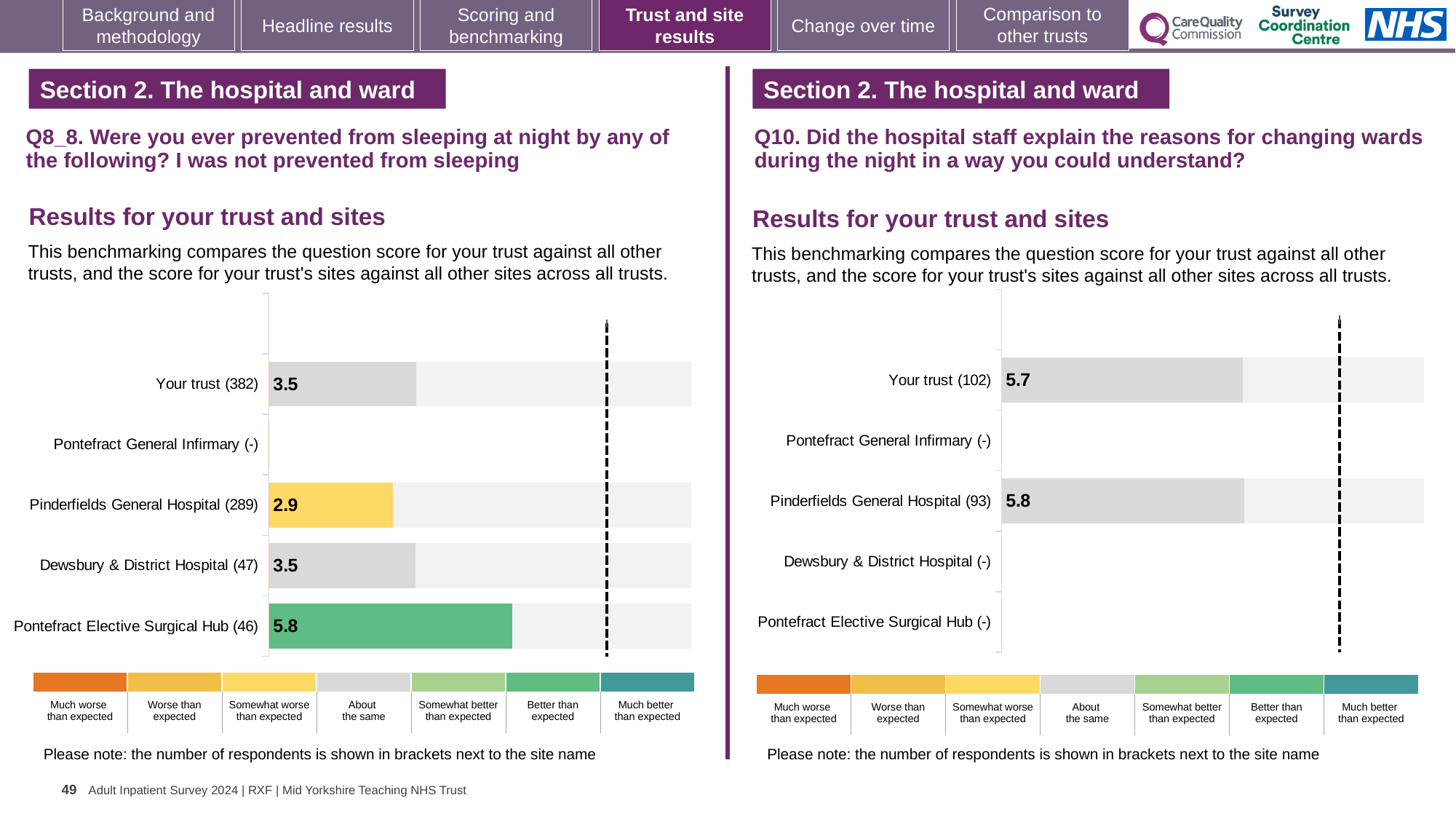
On the Q8_8 chart (left), how many respondents are shown for Dewsbury & District Hospital? 47 On the Q8_8 chart (left), what is the score for Pinderfields General Hospital? 2.9 On the Q10 chart (right), how many respondents are shown for Your trust? 102 On the Q10 chart (right), what is the score for Pinderfields General Hospital? 5.8 On the Q10 chart (right), how many site rows (excluding Your trust) are listed? 4 On the Q8_8 chart (left), which site has the highest score? Pontefract Elective Surgical Hub On the Q8_8 chart (left), what is the score for Pontefract Elective Surgical Hub? 5.8 On the Q8_8 chart (left), which site has the lowest score among those with a plotted value? Pinderfields General Hospital On the Q8_8 chart (left), what is the score for Your trust? 3.5 On the Q10 chart (right), what is the score for Your trust? 5.7 What kind of chart is used on the Q8_8 chart (left)? Bar chart On the Q8_8 chart (left), what is the difference between the scores for Pontefract Elective Surgical Hub and Pinderfields General Hospital? 2.9